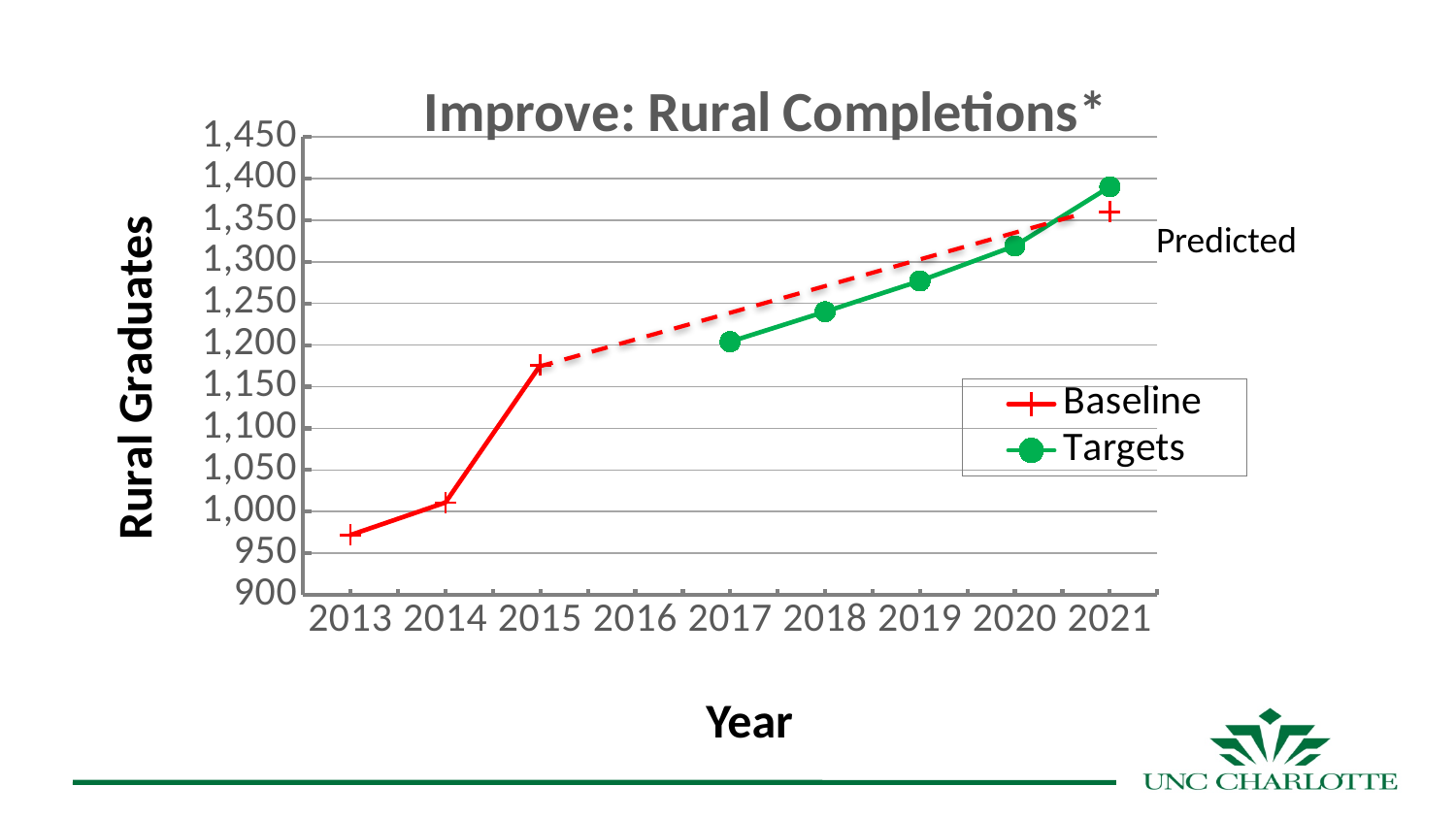
In which year does the Targets series reach its highest value? 2021 Is the Targets value for 2019 greater or less than 1,250? greater What kind of chart is shown on the slide? line chart In which year is the Baseline series at its lowest value? 2013 In 2021, which series has the higher value, Baseline or Targets? Targets Is the Baseline value for 2015 greater or less than 1,150? greater How many series does the legend list? 2 How many data points are plotted for the Targets series? 5 Is the Targets value for 2021 greater or less than 1,350? greater How many years are labelled along the x axis? 9 Do the Targets values rise or fall from 2017 to 2021? rise